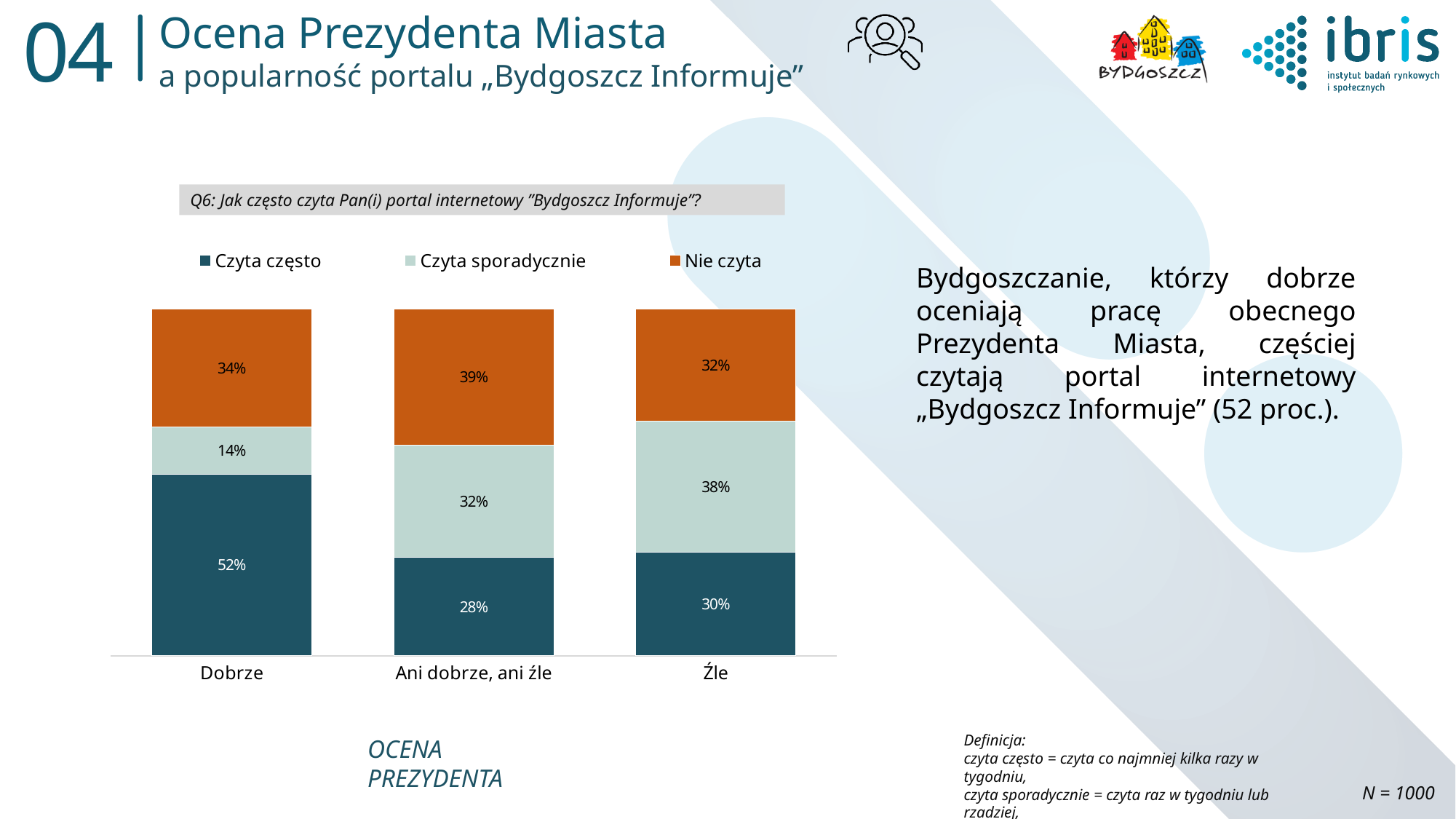
What is the 'Czyta sporadycznie' value for the 'Źle' category? 38% How many categories are shown on the x axis of the chart? 3 What is the total of the stacked bar for 'Ani dobrze, ani źle'? 99% What percentage of respondents who rate the President 'Dobrze' are in the 'Czyta często' group? 52% Which category has the highest 'Czyta często' value? Dobrze What is the 'Nie czyta' value for the 'Ani dobrze, ani źle' category? 39% What is the difference between the 'Czyta często' values for 'Dobrze' and 'Ani dobrze, ani źle'? 24 percentage points What kind of chart is shown on the slide? Stacked bar chart Which category has the lowest 'Czyta sporadycznie' value? Dobrze Which is larger: the 'Nie czyta' value for 'Dobrze' or for 'Źle'? Dobrze Which series is shown in orange in the chart? Nie czyta How many series does the chart legend list? 3